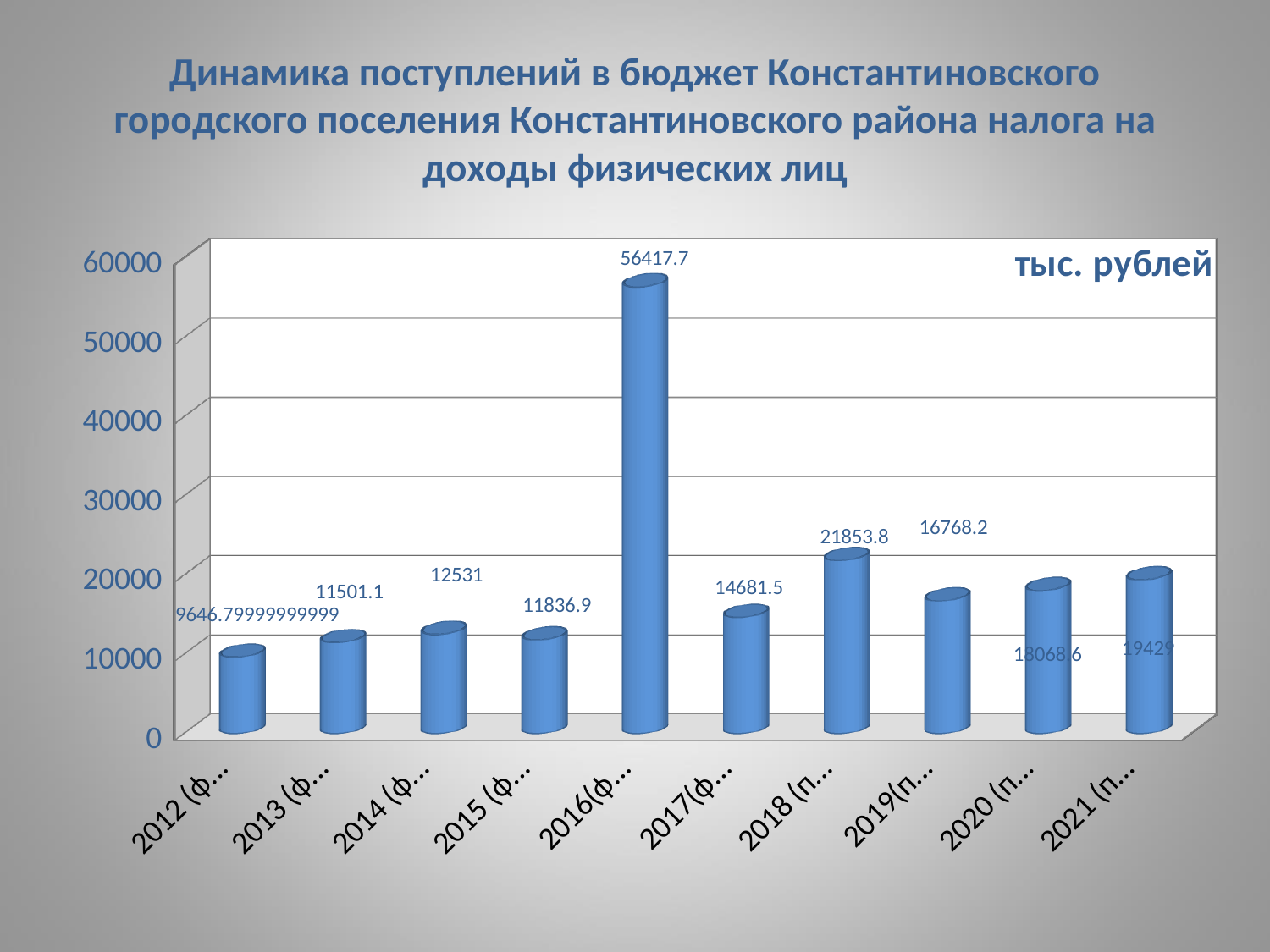
Is the value for 2019 greater or less than 20000? less Do the values rise or fall from 2012 to 2014? rise Which year has the highest value? 2016 What is the difference between the values for 2018 and 2017? 7172.3 What is the value for 2013? 11501.1 What kind of chart is shown on the slide? bar chart Which is larger, the value for 2014 or the value for 2015? 2014 What is the difference between the values for 2019 and 2017? 2086.7 How many years are shown on the x axis? 10 What is the value for 2018? 21853.8 Which year has the lowest value? 2012 What is the value for 2016? 56417.7